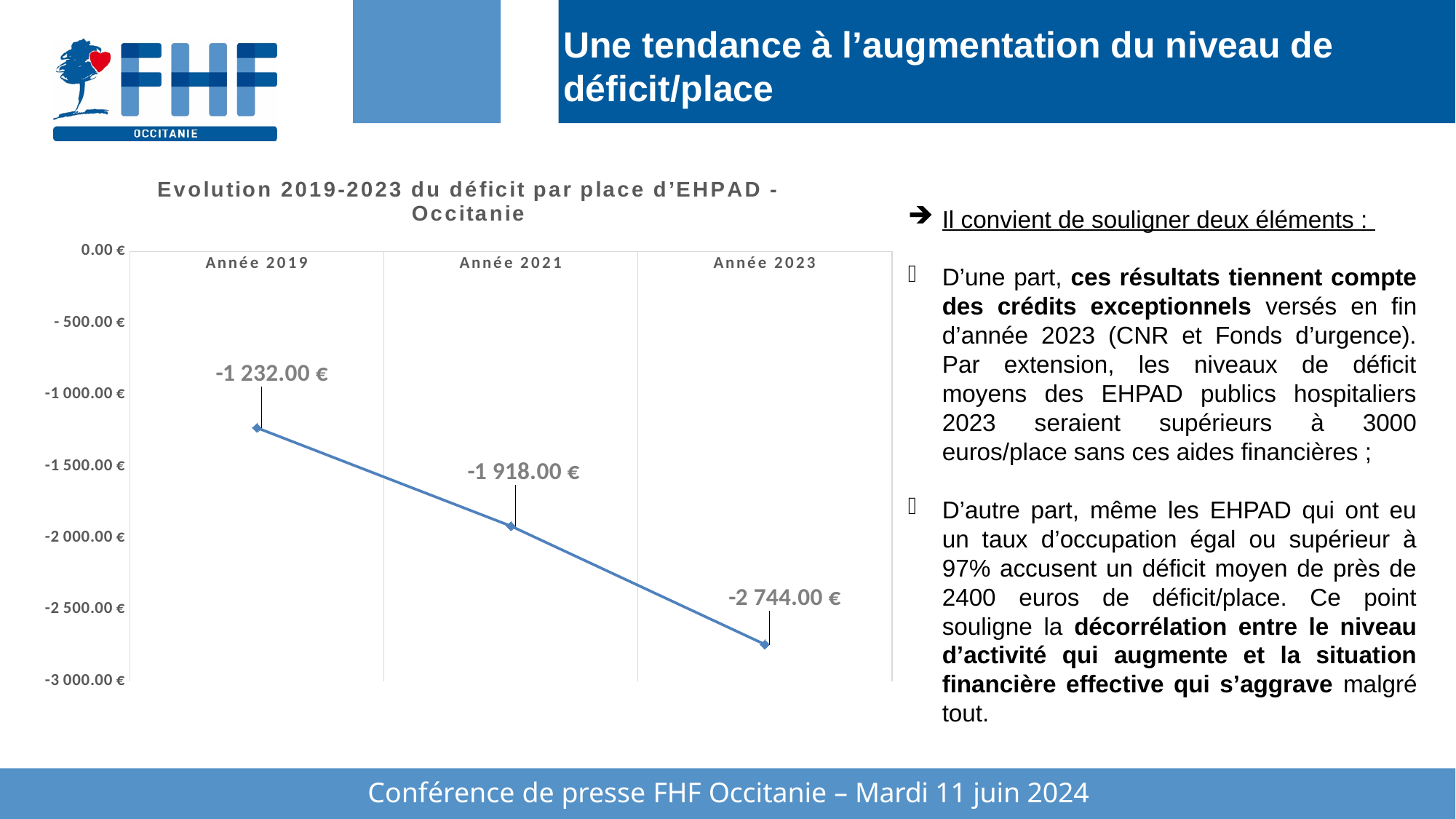
What is the value for Année 2021? -1 918.00 € Which year has the highest (least negative) value? Année 2019 What kind of chart is shown on the slide? Line chart What is the value for Année 2023? -2 744.00 € Which year has the lowest (most negative) value? Année 2023 Do the values rise or fall from Année 2019 to Année 2023? Fall What is the difference between the values for Année 2019 and Année 2023? 1 512.00 € What is the value for Année 2019? -1 232.00 € How many data points are plotted on the chart? 3 Which is larger, the value for Année 2019 or the value for Année 2021? Année 2019 What is the difference between the values for Année 2021 and Année 2023? 826.00 € Is the value for Année 2021 greater or less than -2 000.00 €? greater